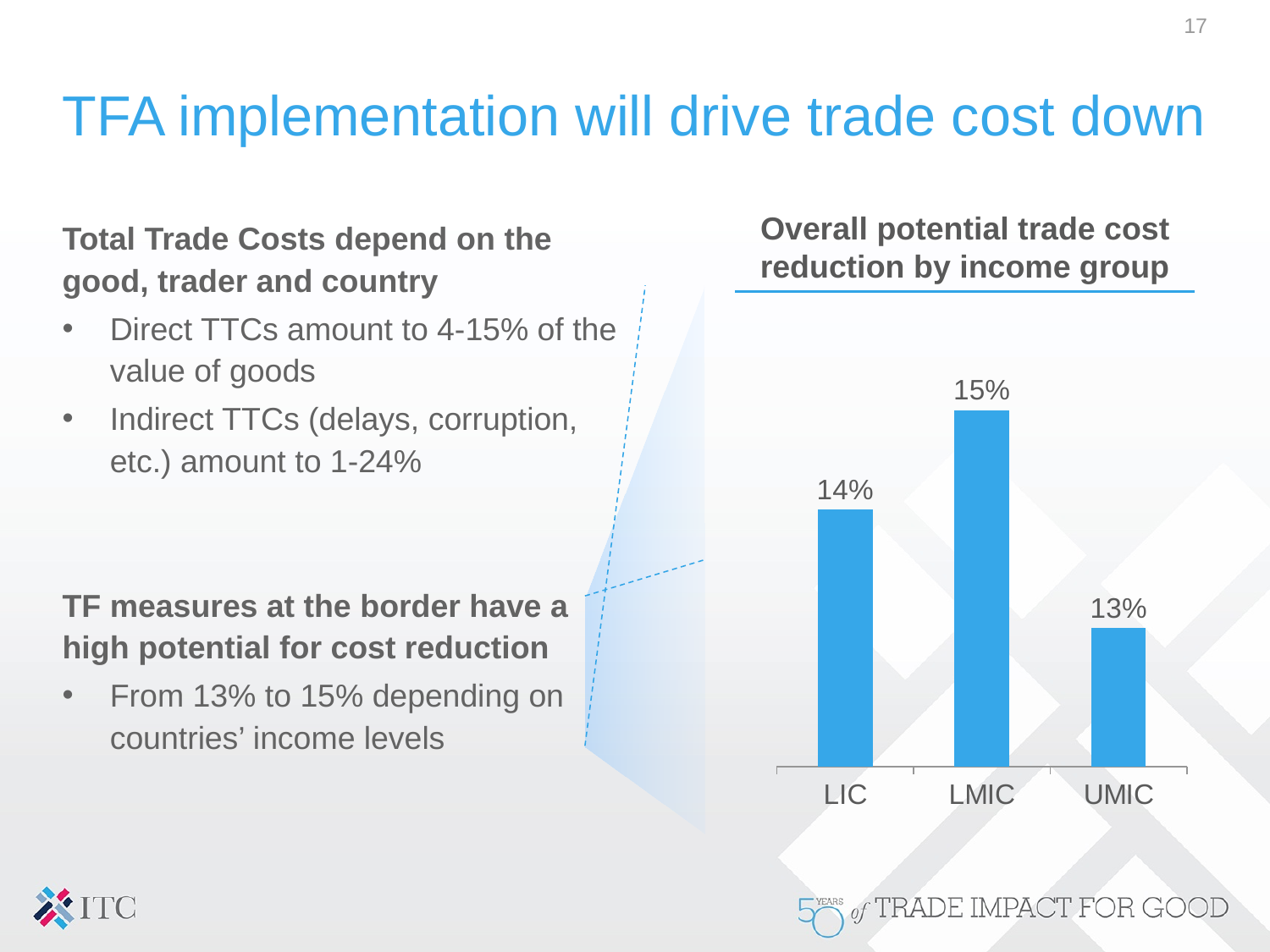
What colour are the bars in the chart? Blue Which income group has the highest potential trade cost reduction? LMIC What kind of chart is used to show potential trade cost reduction by income group? Bar chart How many income groups are shown in the chart? 3 What is the title of the chart? Overall potential trade cost reduction by income group What is the difference between the potential trade cost reduction for LIC and UMIC? 1% What is the overall potential trade cost reduction for LMIC? 15% Which has a larger potential trade cost reduction, LIC or LMIC? LMIC What is the overall potential trade cost reduction for UMIC? 13% Which income group has the lowest potential trade cost reduction? UMIC What is the overall potential trade cost reduction for LIC? 14% What is the difference between the potential trade cost reduction for LMIC and UMIC? 2%